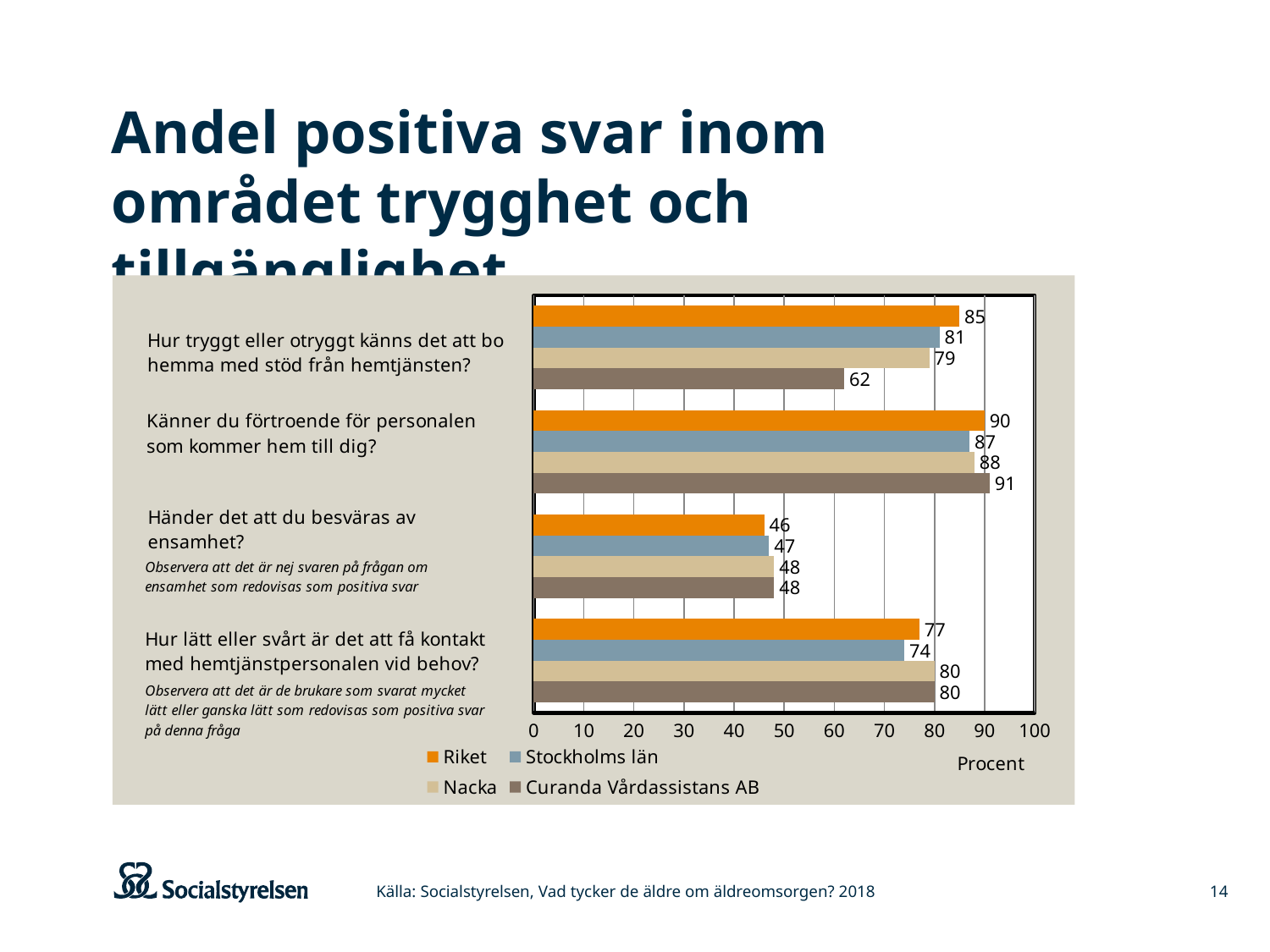
How many question categories are shown on the chart? 4 What is the value for Curanda Vårdassistans AB on the question "Hur tryggt eller otryggt känns det att bo hemma med stöd från hemtjänsten?"? 62 Which is larger on the question "Hur lätt eller svårt är det att få kontakt med hemtjänstpersonalen vid behov?": Riket or Nacka? Nacka What is the value for Stockholms län on the question "Hur lätt eller svårt är det att få kontakt med hemtjänstpersonalen vid behov?"? 74 What is the difference between Riket and Curanda Vårdassistans AB on the question "Hur tryggt eller otryggt känns det att bo hemma med stöd från hemtjänsten?"? 23 Which series has the highest value on the question "Känner du förtroende för personalen som kommer hem till dig?"? Curanda Vårdassistans AB How many series does the legend list? 4 What is the value for Riket on the question "Känner du förtroende för personalen som kommer hem till dig?"? 90 What is the value for Nacka on the question "Händer det att du besväras av ensamhet?"? 48 Which series has the lowest value on the question "Hur tryggt eller otryggt känns det att bo hemma med stöd från hemtjänsten?"? Curanda Vårdassistans AB Is the value for Riket on the question "Händer det att du besväras av ensamhet?" greater or less than 50? less What kind of chart is shown on the slide? Bar chart